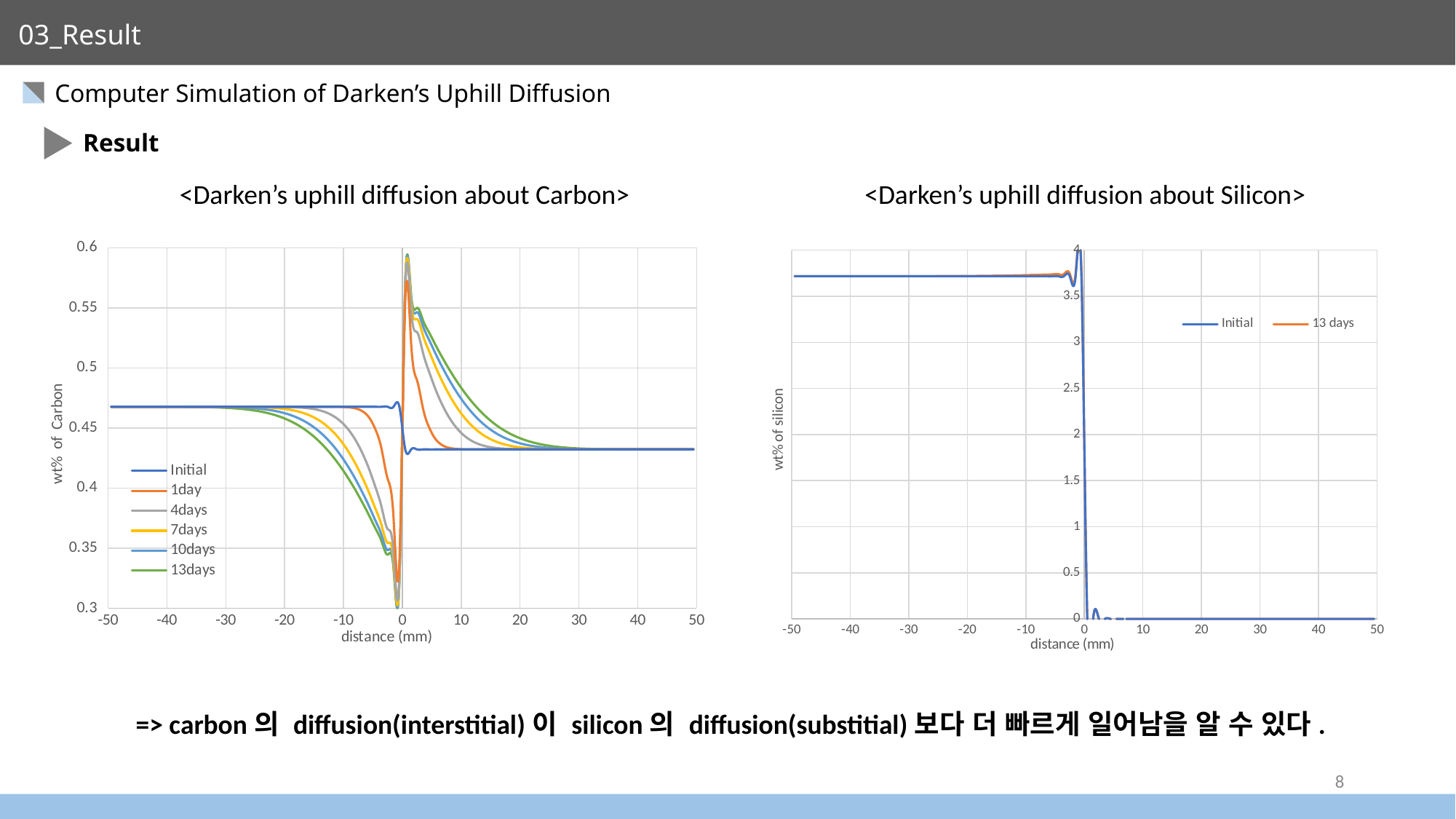
How many series does the legend of the Darken's uphill diffusion about Silicon chart list? 2 What type of chart is the Darken's uphill diffusion about Carbon chart? line chart How many series does the legend of the Darken's uphill diffusion about Carbon chart list? 6 In the Darken's uphill diffusion about Carbon chart, does the 13days series rise or fall as distance goes from -20 mm to -5 mm? fall In the Darken's uphill diffusion about Silicon chart, is the Initial value larger at distance -50 mm or at distance 50 mm? -50 mm In the Darken's uphill diffusion about Silicon chart, is the Initial value at distance -50 mm greater or less than 3.5? greater In the Darken's uphill diffusion about Carbon chart, is the Initial value at distance 50 mm greater or less than 0.45? less In the Darken's uphill diffusion about Carbon chart, is the Initial value larger at distance -50 mm or at distance 50 mm? -50 mm In the Darken's uphill diffusion about Silicon chart, is the Initial value at distance 50 mm greater or less than 0.5? less What is the y-axis label of the Darken's uphill diffusion about Silicon chart? wt% of silicon What is the x-axis label of the Darken's uphill diffusion about Carbon chart? distance (mm)